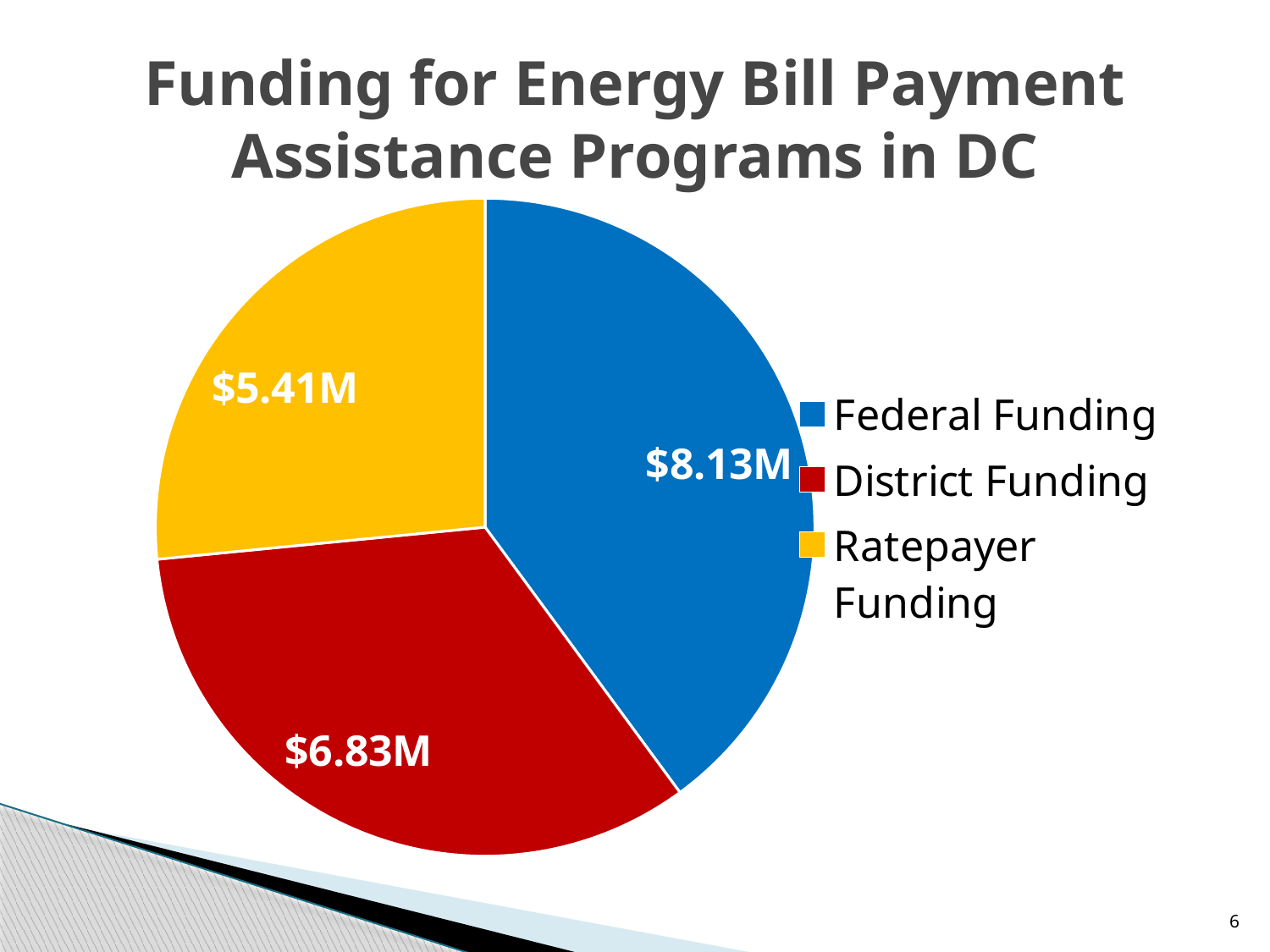
What is the difference between Federal Funding and District Funding? $1.30M Which colour represents Ratepayer Funding in the chart? Yellow What is the title of the chart? Funding for Energy Bill Payment Assistance Programs in DC How many slices does the pie chart have? 3 Which is larger, District Funding or Ratepayer Funding? District Funding Which funding source has the largest value? Federal Funding How many entries does the legend list? 3 Which funding source has the smallest value? Ratepayer Funding What is the value for Federal Funding? $8.13M What type of chart is shown on the slide? Pie chart What is the value for Ratepayer Funding? $5.41M What is the value for District Funding? $6.83M